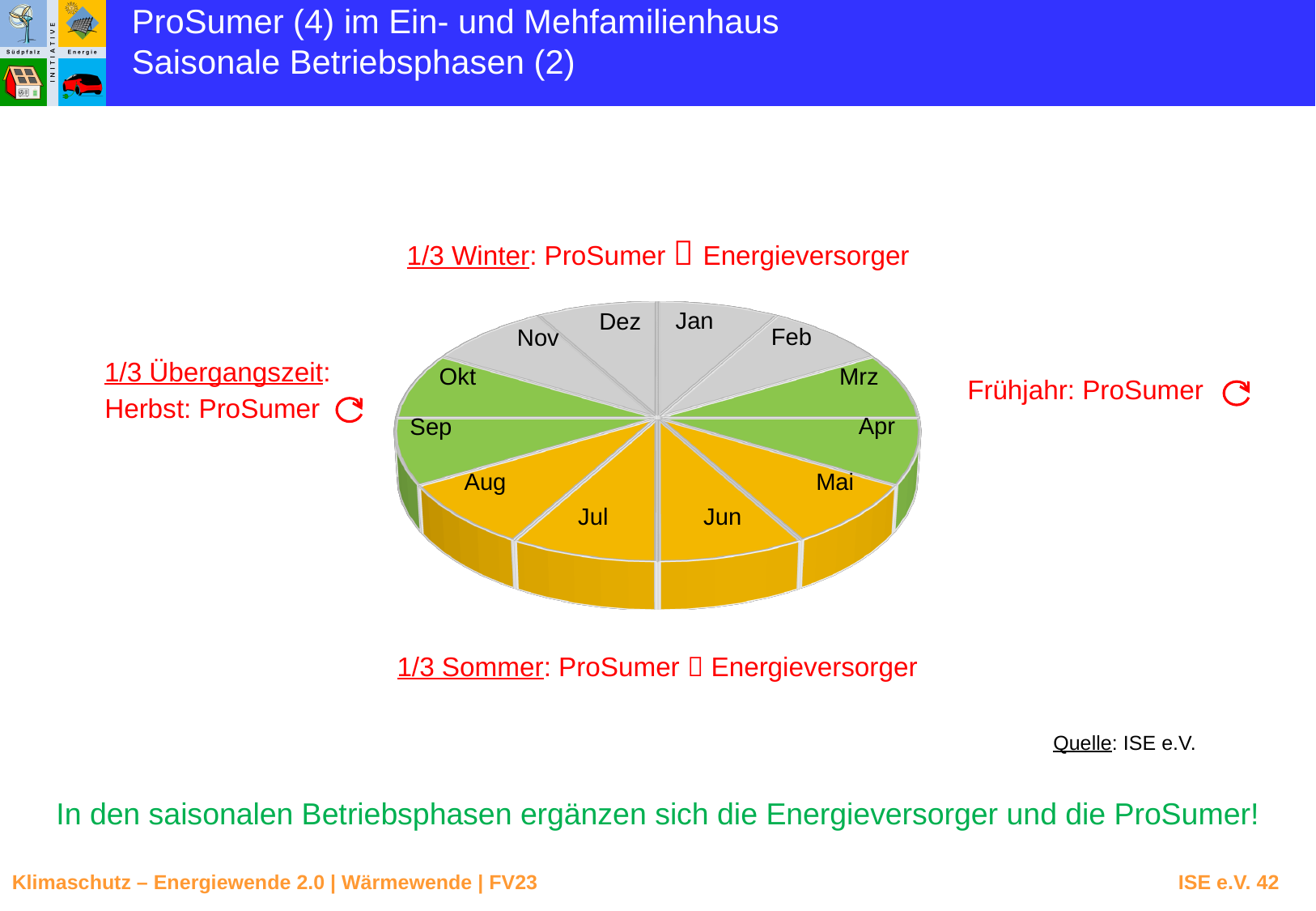
How many slices does the pie chart have? 12 What kind of chart is shown on the slide? pie chart According to the slide, what share of the year is labelled as Sommer? 1/3 According to the slide, what share of the year is labelled as Übergangszeit? 1/3 Which slice of the pie chart lies between Aug and Okt? Sep Which months are shown in grey on the pie chart? Nov, Dez, Jan, Feb Which slice of the pie chart lies between Dez and Feb? Jan What colour are the Jun and Jul slices of the pie chart? yellow According to the slide, what share of the year is labelled as Winter? 1/3